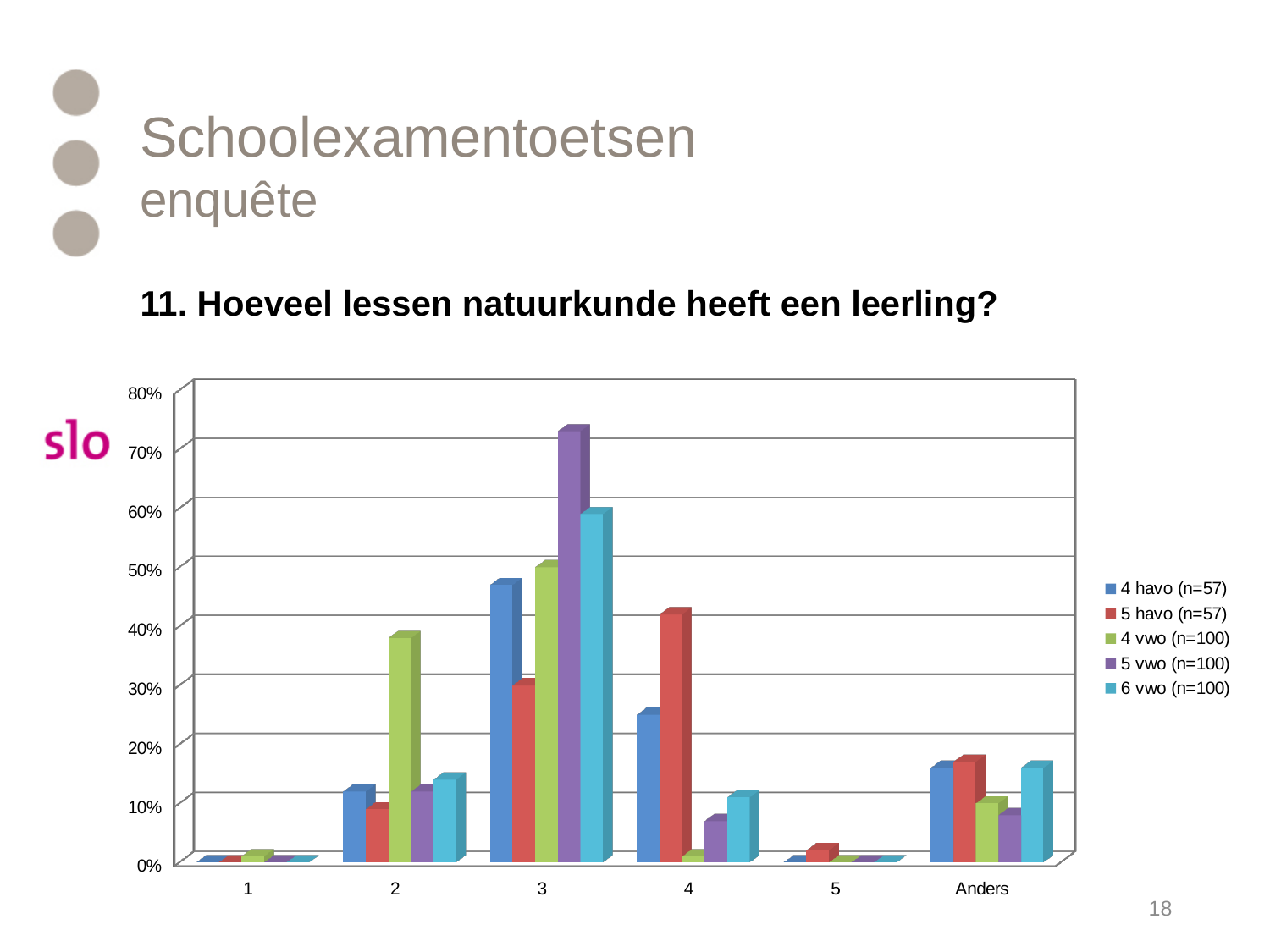
For which category is the 5 vwo (n=100) bar the highest? 3 Is the value for 5 havo (n=57) in category 3 greater or less than 40%? less Is the value for 4 vwo (n=100) in category 2 greater or less than 30%? greater What kind of chart is shown on the slide? bar chart How many categories are shown on the x axis of the chart? 6 According to the legend, what is the sample size (n) for the 4 havo series? n=57 Which series has the highest bar for category 2? 4 vwo (n=100) Which series has the highest bar for category 3? 5 vwo (n=100) Is the value for 5 vwo (n=100) in category 3 greater or less than 60%? greater For category 3, which is larger: the 5 vwo (n=100) bar or the 6 vwo (n=100) bar? 5 vwo (n=100) How many series does the chart's legend list? 5